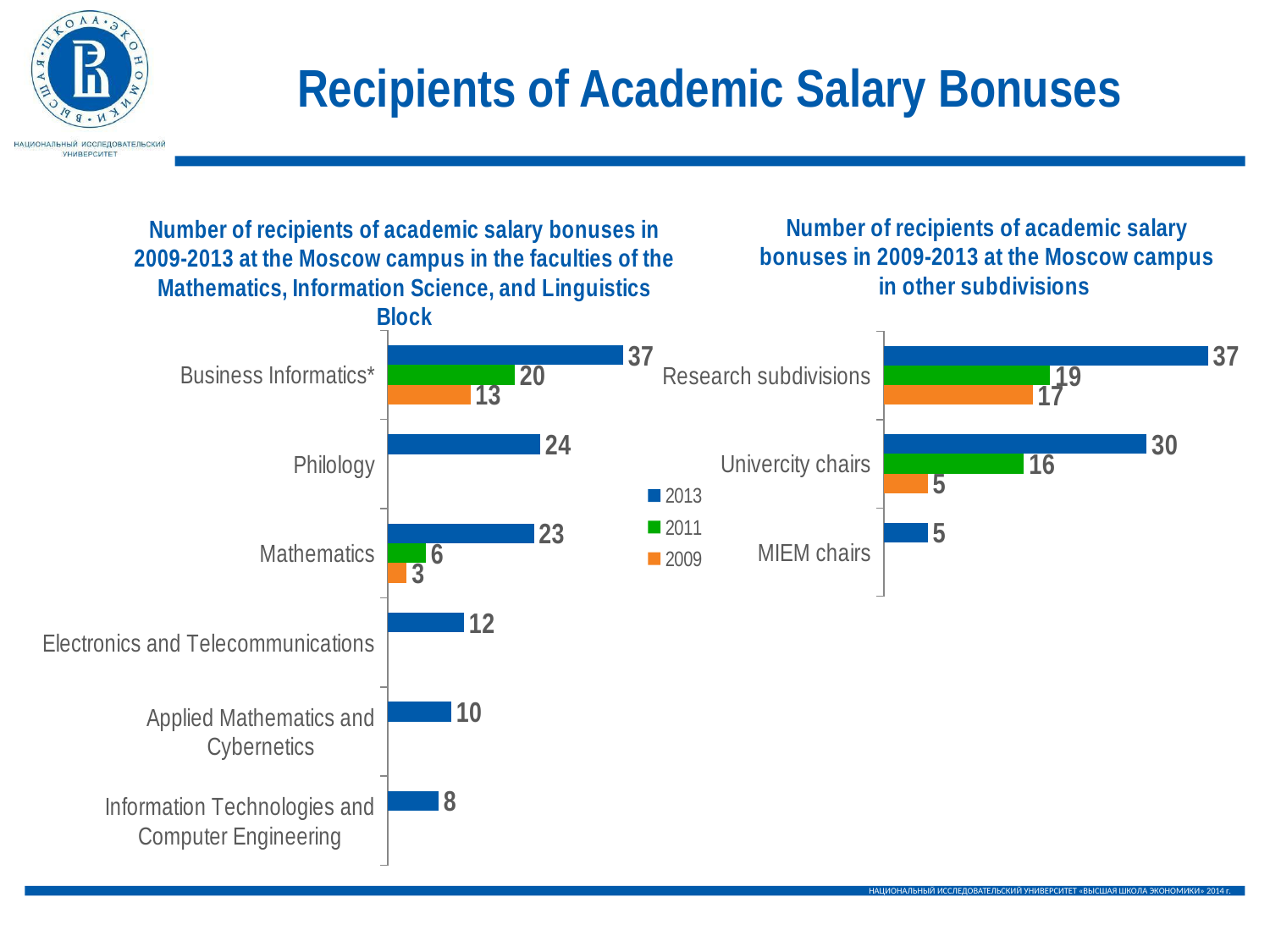
In the left chart (Mathematics, Information Science, and Linguistics Block), which category has the lowest 2013 value? Information Technologies and Computer Engineering What kind of chart is the left chart (Mathematics, Information Science, and Linguistics Block)? Bar chart In the left chart (Mathematics, Information Science, and Linguistics Block), what is the difference between the 2013 and 2011 values for Business Informatics*? 17 In the right chart (other subdivisions), what is the 2009 value for Univercity chairs? 5 In the left chart (Mathematics, Information Science, and Linguistics Block), what is the 2009 value for Mathematics? 3 In the right chart (other subdivisions), which is larger: the 2013 value for Univercity chairs or the 2013 value for MIEM chairs? Univercity chairs In the right chart (other subdivisions), which category has the highest 2013 value? Research subdivisions In the left chart (Mathematics, Information Science, and Linguistics Block), what is the 2013 value for Business Informatics*? 37 How many series does the legend list? 3 In the right chart (other subdivisions), what is the 2011 value for Research subdivisions? 19 In the left chart (Mathematics, Information Science, and Linguistics Block), how many categories are shown? 6 In the left chart (Mathematics, Information Science, and Linguistics Block), what is the 2013 value for Philology? 24